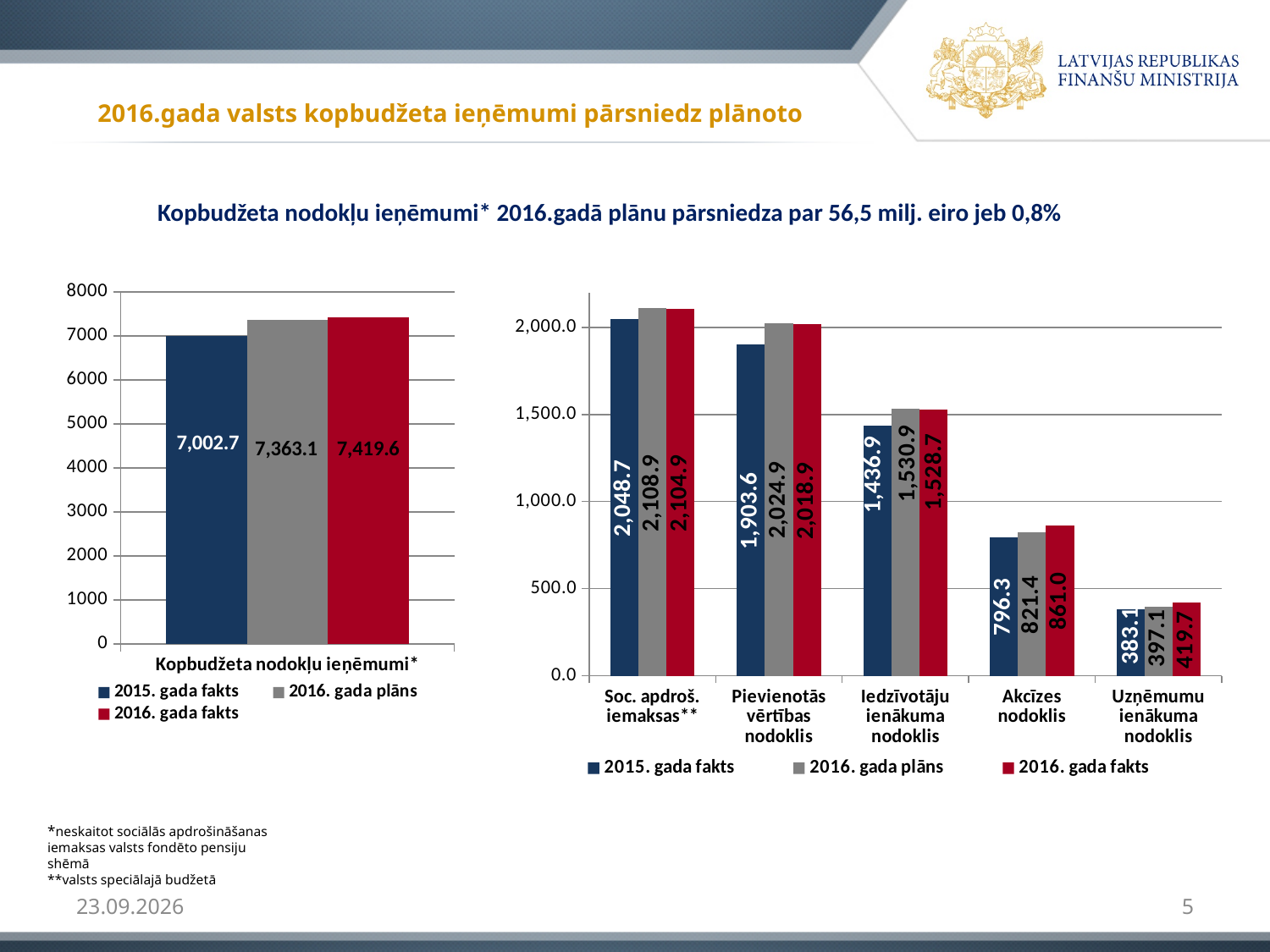
In the left chart, what is the value for 2016. gada fakts? 7,419.6 In the right chart, is the 2016. gada fakts value for Iedzīvotāju ienākuma nodoklis larger or smaller than the 2016. gada plāns value for the same category? smaller What kind of chart is the right chart? bar chart In the right chart, what is the 2016. gada plāns value for Pievienotās vērtības nodoklis? 2,024.9 In the right chart, which category has the highest 2015. gada fakts value? Soc. apdroš. iemaksas** In the right chart, which category has the lowest 2016. gada fakts value? Uzņēmumu ienākuma nodoklis In the left chart, what is the difference between the 2016. gada fakts and 2016. gada plāns values? 56.5 In the right chart, how many categories are shown on the x axis? 5 In the left chart, what is the value for 2015. gada fakts? 7,002.7 In the right chart, what is the 2015. gada fakts value for Akcīzes nodoklis? 796.3 In the left chart, how many series does the legend list? 3 In the right chart, what is the difference between the 2016. gada fakts and 2015. gada fakts values for Akcīzes nodoklis? 64.7